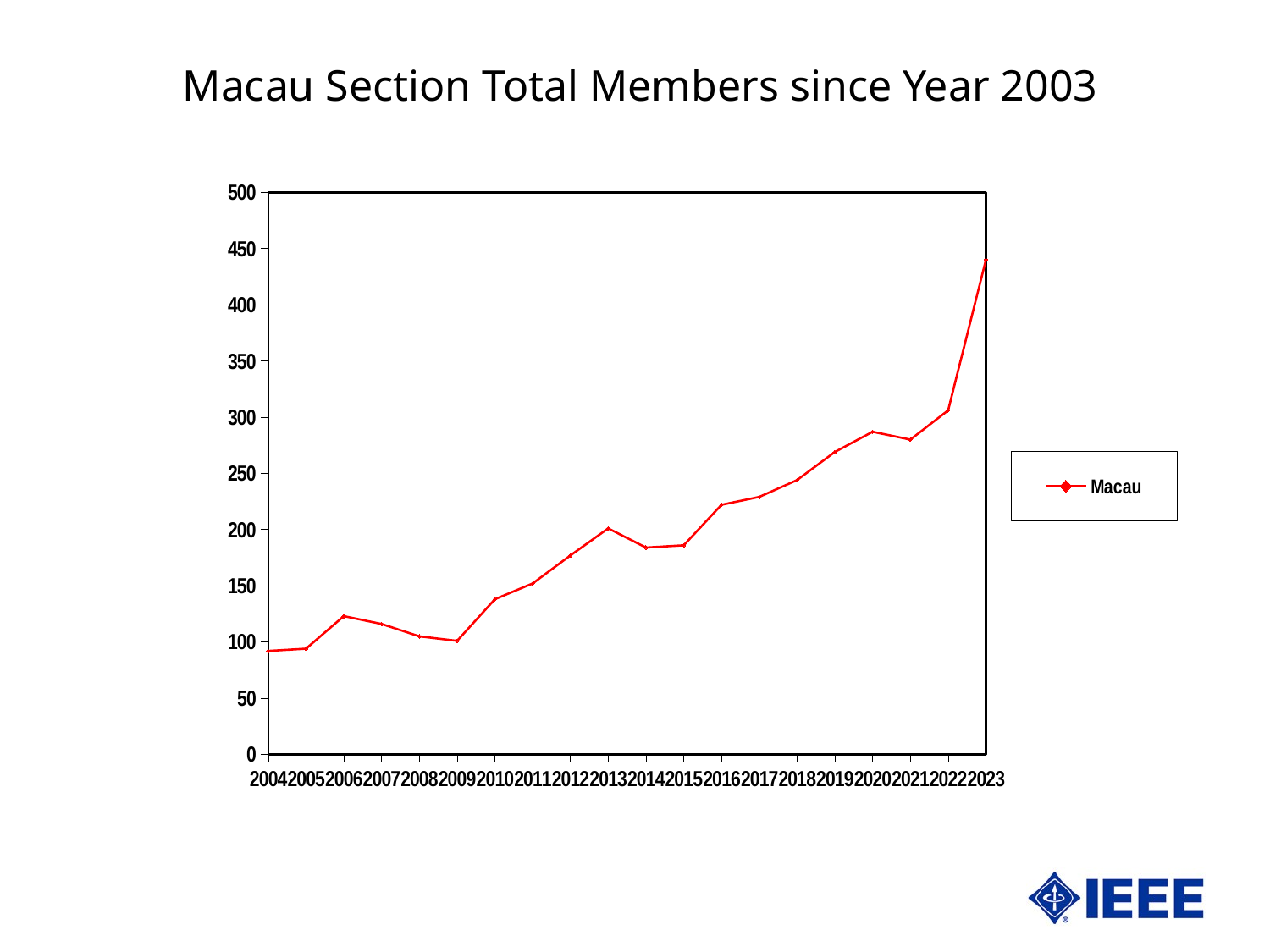
Is the value for 2022 greater or less than 300? greater How many years are plotted along the x axis? 20 Overall, do the values rise or fall from 2004 to 2023? rise Which year has the highest number of members? 2023 Is the value for 2010 greater or less than 150? less Which year has the larger value, 2013 or 2014? 2013 Is the value for 2004 greater or less than 100? less What kind of chart is shown on the slide? line chart How many series does the legend list? 1 What is the title of the chart? Macau Section Total Members since Year 2003